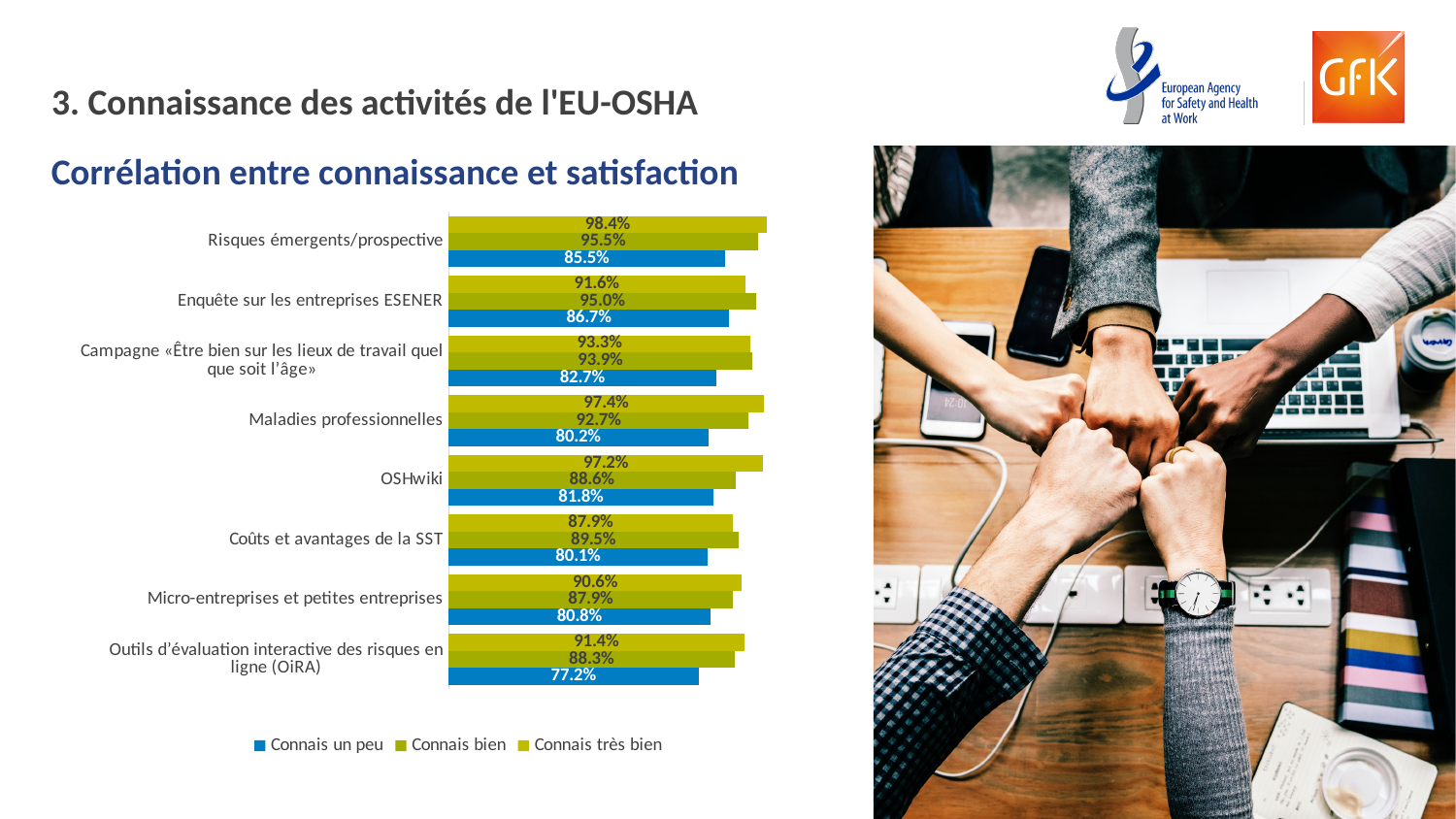
Which category has the lowest 'Connais un peu' value? Outils d'évaluation interactive des risques en ligne (OiRA) What is the 'Connais un peu' value for Outils d'évaluation interactive des risques en ligne (OiRA)? 77.2% What type of chart is shown on the slide? bar chart Which category has the highest 'Connais un peu' value? Enquête sur les entreprises ESENER Which category has the highest 'Connais très bien' value? Risques émergents/prospective What is the 'Connais très bien' value for Maladies professionnelles? 97.4% How many series does the legend list? 3 What is the 'Connais bien' value for OSHwiki? 88.6% What is the 'Connais un peu' value for Risques émergents/prospective? 85.5% How many categories (EU-OSHA activities) are shown on the chart? 8 Which is larger for Coûts et avantages de la SST: the 'Connais bien' value or the 'Connais très bien' value? Connais bien What is the difference between the 'Connais très bien' and 'Connais un peu' values for Risques émergents/prospective? 12.9%